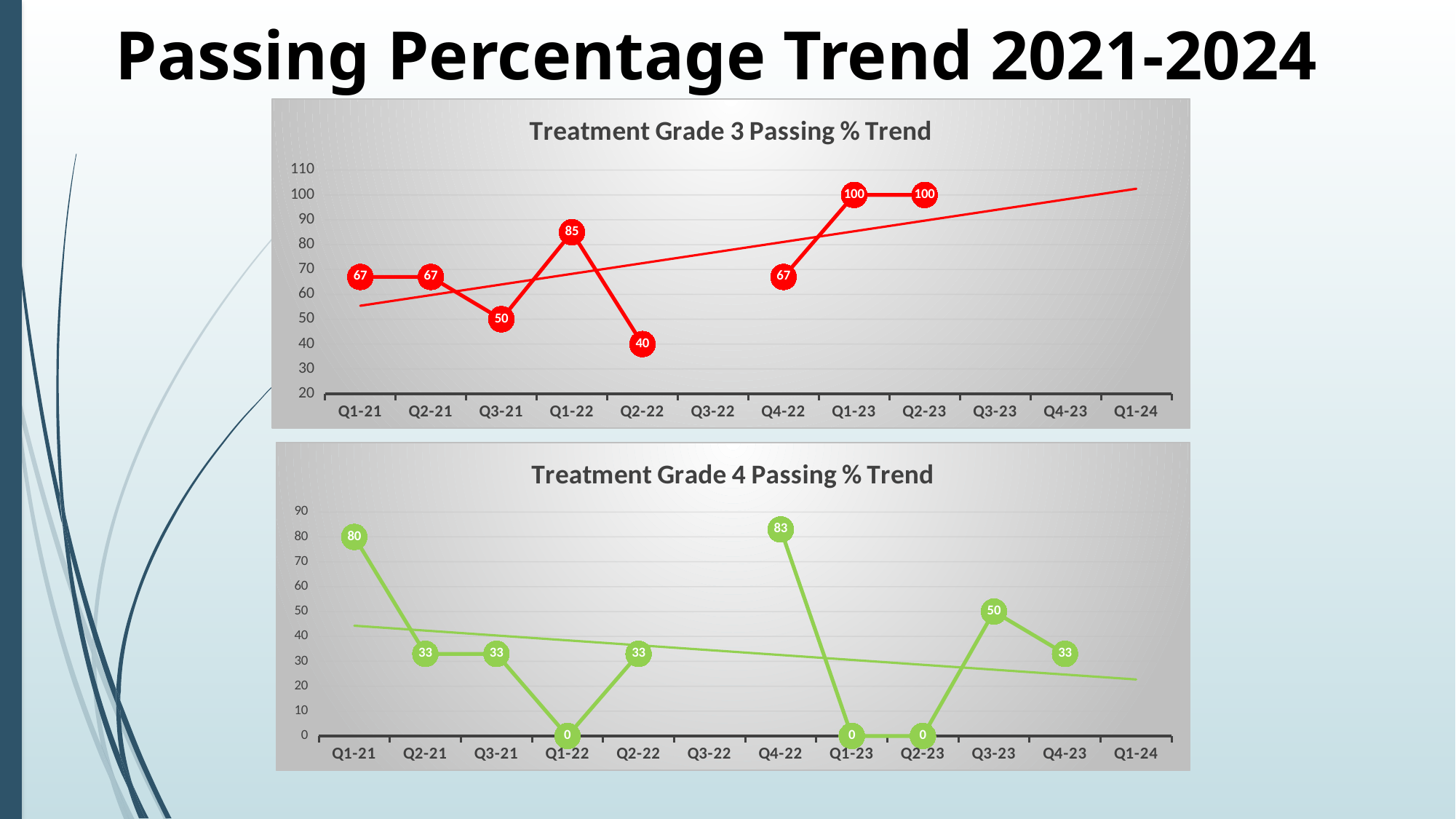
What kind of chart is the Treatment Grade 4 Passing % Trend chart? line chart In the Treatment Grade 3 Passing % Trend chart, does the straight trend line rise or fall from left to right? rise In the Treatment Grade 4 Passing % Trend chart, what is the value for Q3-23? 50 In the Treatment Grade 3 Passing % Trend chart, which is larger, the value for Q3-21 or the value for Q1-22? Q1-22 In the Treatment Grade 3 Passing % Trend chart, what is the value for Q2-22? 40 In the Treatment Grade 4 Passing % Trend chart, does the straight trend line rise or fall from left to right? fall In the Treatment Grade 3 Passing % Trend chart, which quarter has the lowest plotted value? Q2-22 In the Treatment Grade 4 Passing % Trend chart, which quarter has the highest plotted value? Q4-22 In the Treatment Grade 4 Passing % Trend chart, what is the value for Q4-22? 83 In the Treatment Grade 4 Passing % Trend chart, what is the difference between the Q1-21 value and the Q2-21 value? 47 In the Treatment Grade 3 Passing % Trend chart, what is the difference between the Q1-23 value and the Q4-22 value? 33 In the Treatment Grade 3 Passing % Trend chart, what is the value for Q1-22? 85